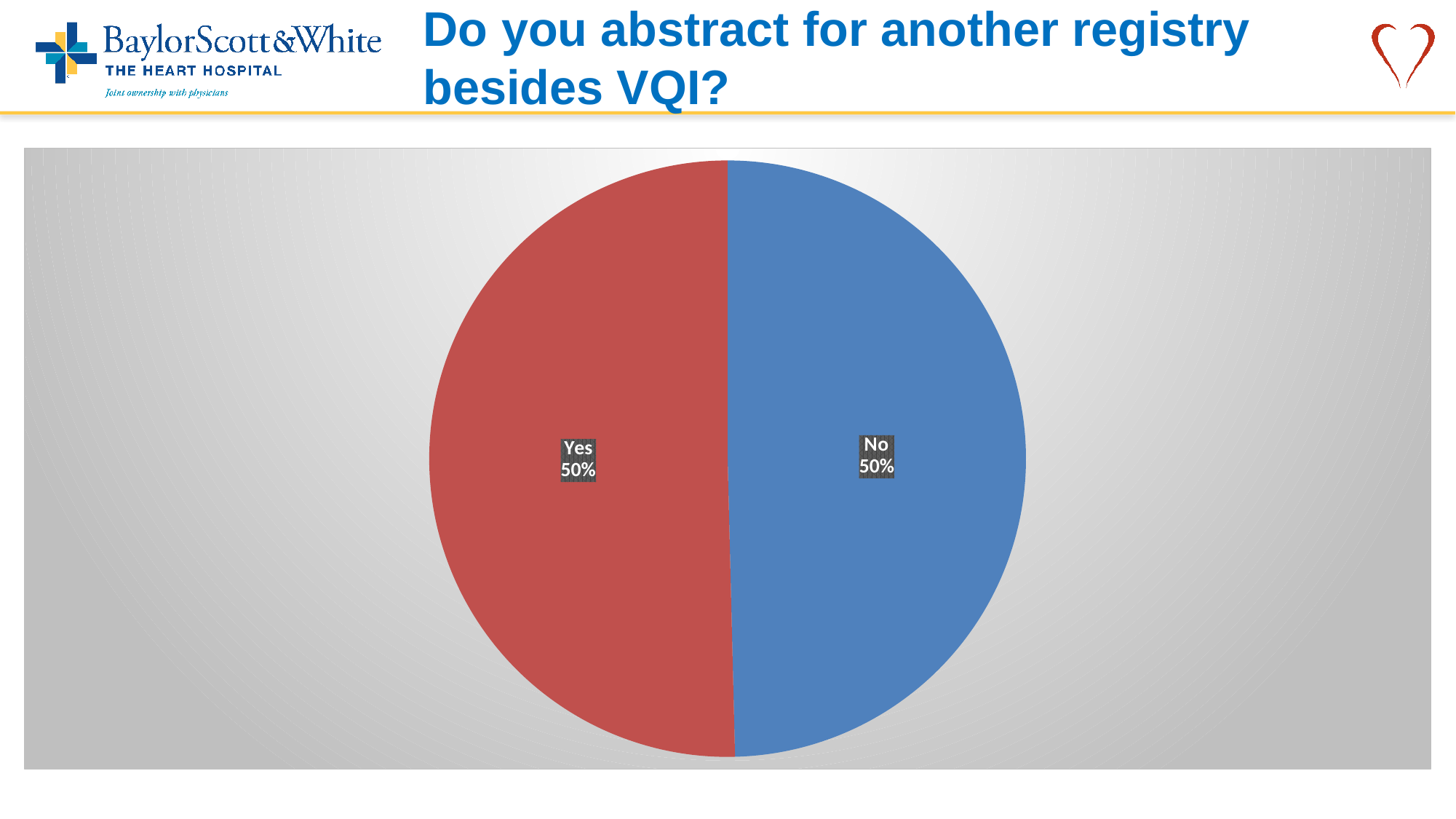
What share of the pie does the "No" slice represent? 50% What share of the pie does the "Yes" slice represent? 50% What kind of chart is shown on the slide? pie chart What is the combined percentage of the "Yes" and "No" slices? 100% Is the value for "Yes" greater or less than 40%? greater What colour is the "Yes" slice? red What is the difference between the "Yes" and "No" percentages? 0% What colour is the "No" slice? blue Is the value for "No" greater or less than 60%? less How many slices does the pie chart have? 2